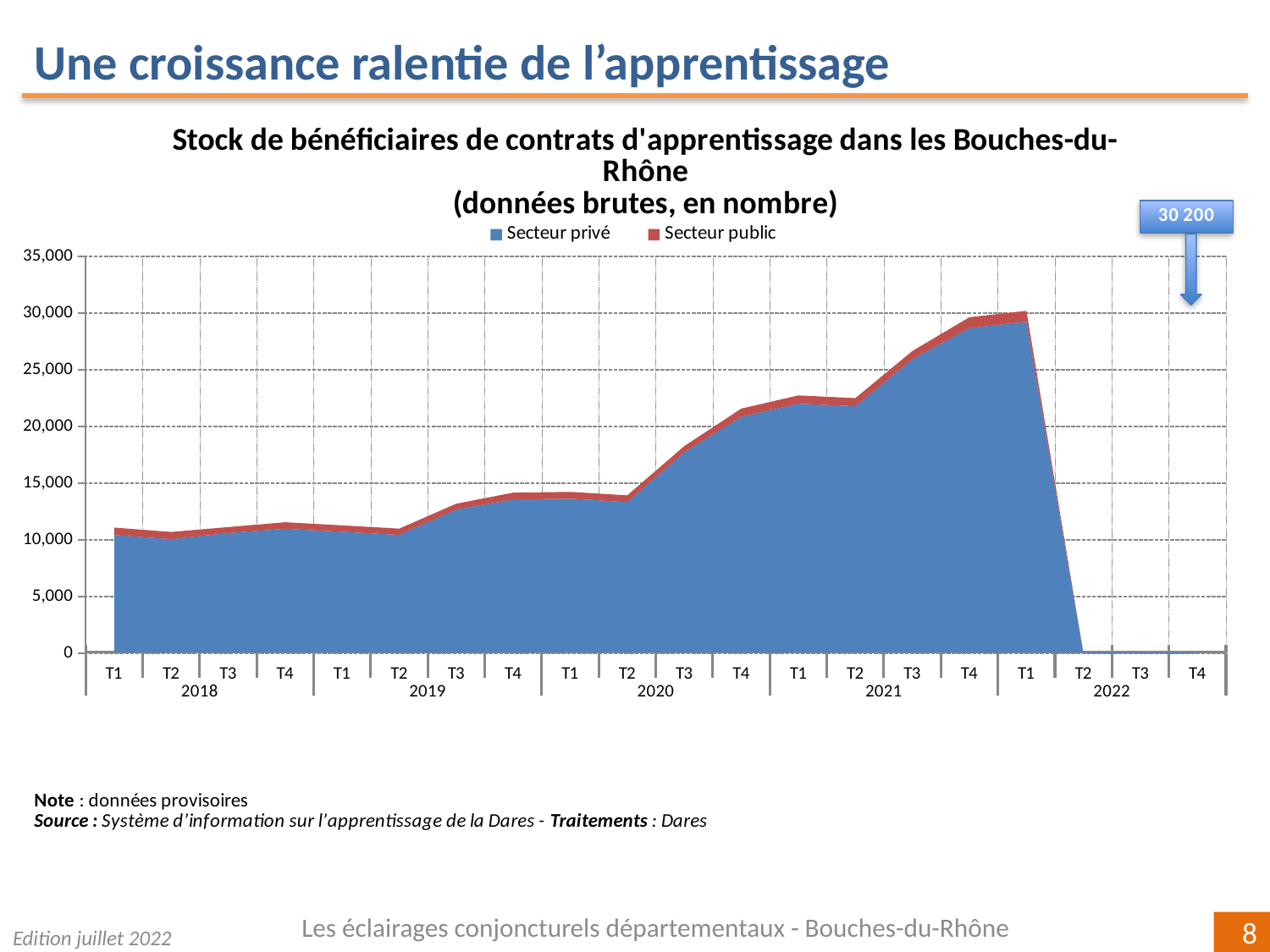
Which is larger, the total for T4 2021 or the total for T4 2020? T4 2021 Which series is shown in blue in the legend? Secteur privé What value is shown in the callout box at the top right of the chart? 30 200 Which quarter has the highest total stock of apprenticeship contracts? T1 2022 What kind of chart is shown on the slide? Area chart Is the total value for T3 2020 greater or less than 20,000? less How many series does the legend list? 2 How many years are labelled along the x axis? 5 Is the total value for T1 2021 greater or less than 20,000? greater Do the total values rise or fall from T2 2020 to T1 2022? Rise Is the total value for T1 2018 greater or less than 15,000? less